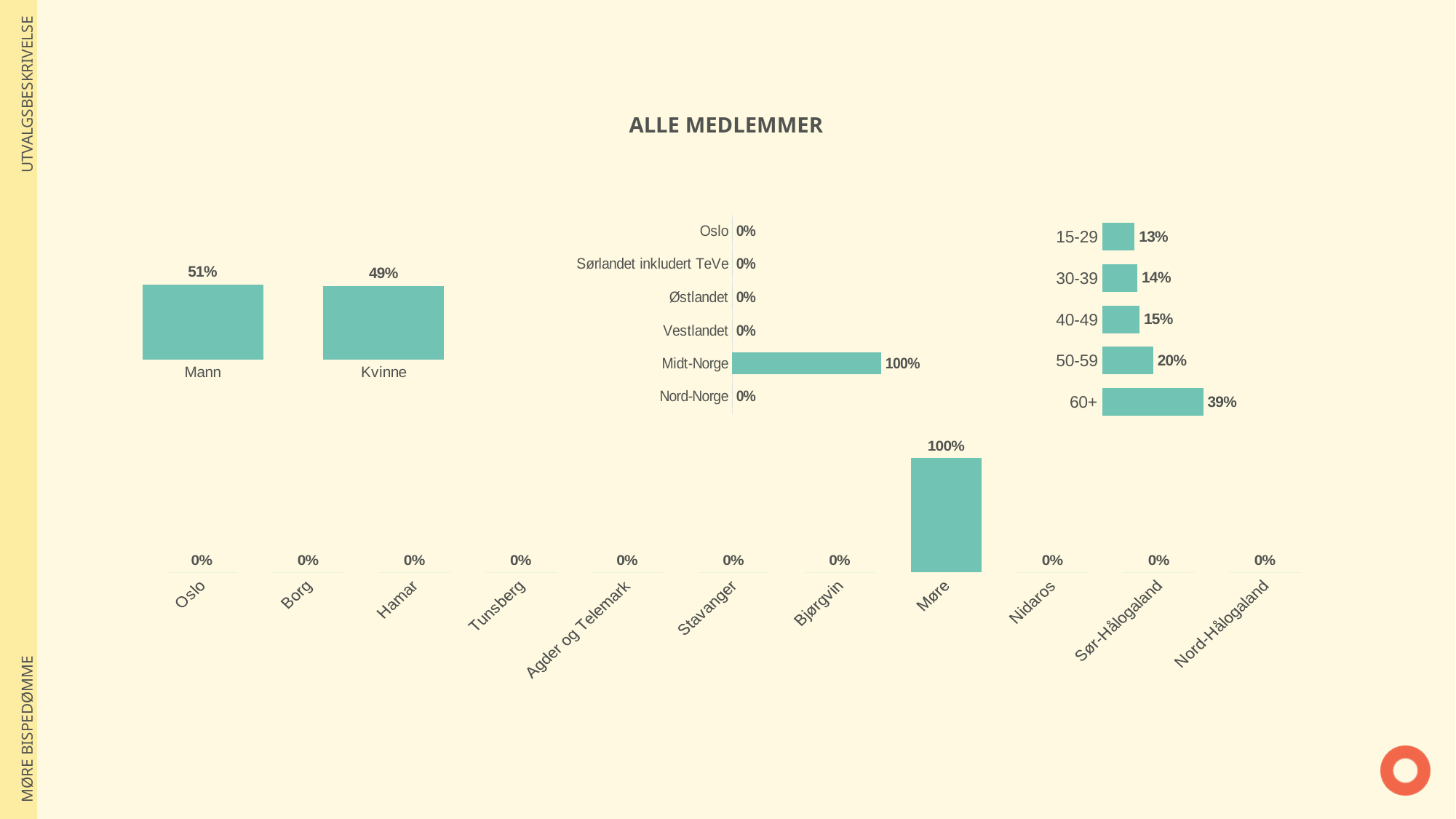
In the gender chart at the top left, what is the value for Mann? 51% In the diocese chart at the bottom, which diocese has the highest value? Møre In the age chart at the top right, which age group has the highest value? 60+ In the age chart at the top right, what is the difference between 60+ and 40-49? 24% In the age chart at the top right, which age group has the lowest value? 15-29 In the region chart at the top middle, what is the value for Midt-Norge? 100% In the gender chart at the top left, what is the value for Kvinne? 49% In the age chart at the top right, what is the value for 50-59? 20% In the diocese chart at the bottom, how many dioceses are shown on the x axis? 11 In the region chart at the top middle, how many regions are listed? 6 In the gender chart at the top left, what is the difference between Mann and Kvinne? 2% In the age chart at the top right, which is larger, 30-39 or 40-49? 40-49